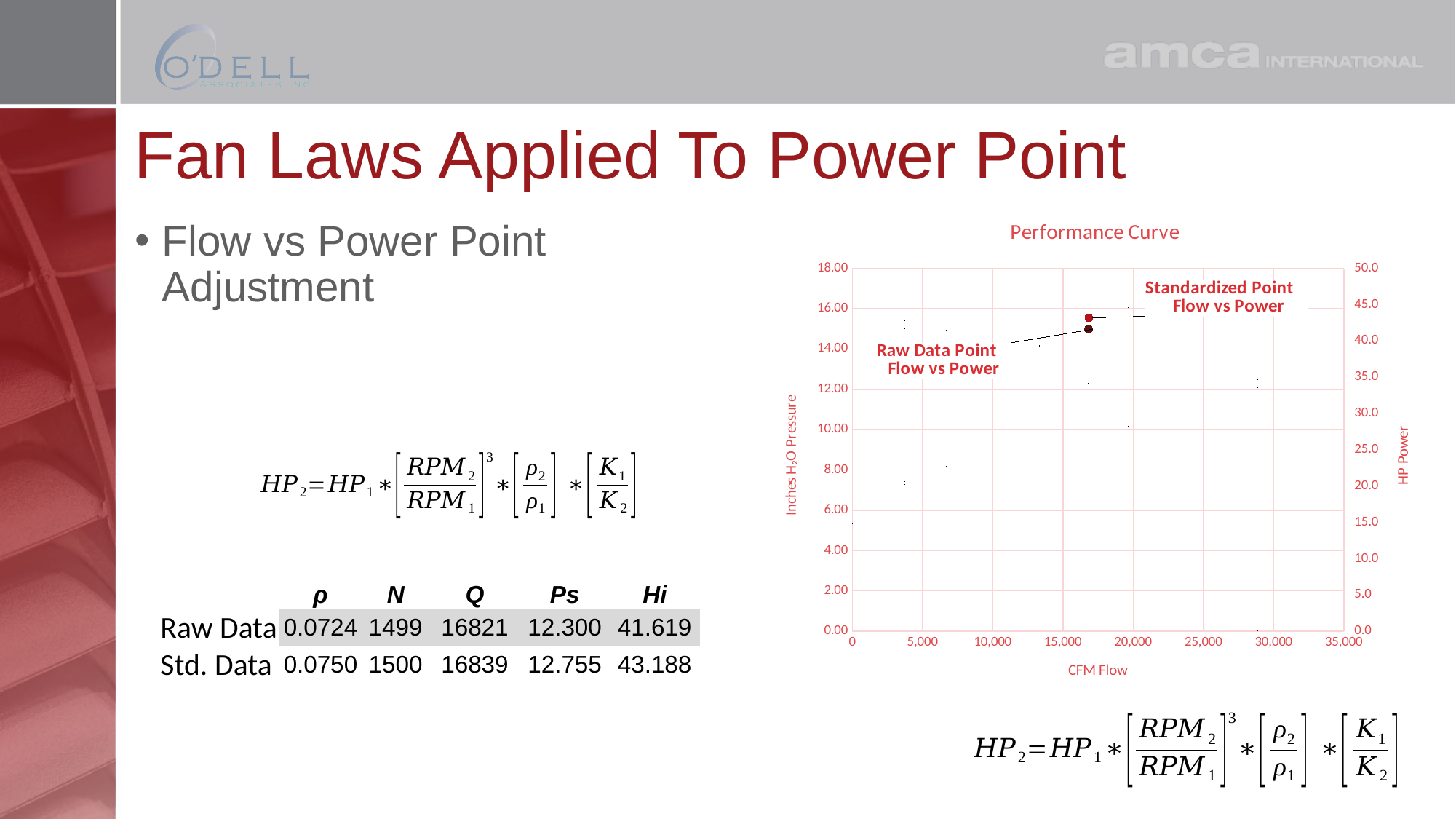
On the Performance Curve chart, which labeled point has the higher HP Power, the Raw Data Point or the Standardized Point? Standardized Point What is the label of the right-hand vertical axis of the Performance Curve chart? HP Power What is the title of the chart on the slide? Performance Curve On the Performance Curve chart, is the HP Power value of the Standardized Point greater or less than 45.0? less On the Performance Curve chart, is the HP Power value of the Raw Data Point greater or less than 40.0? greater How many labeled data points are marked on the Performance Curve chart? 2 On the Performance Curve chart, is the CFM Flow of the Standardized Point greater or less than 20,000? less On the Performance Curve chart, does the plotted curve rise or fall as CFM Flow increases? rise